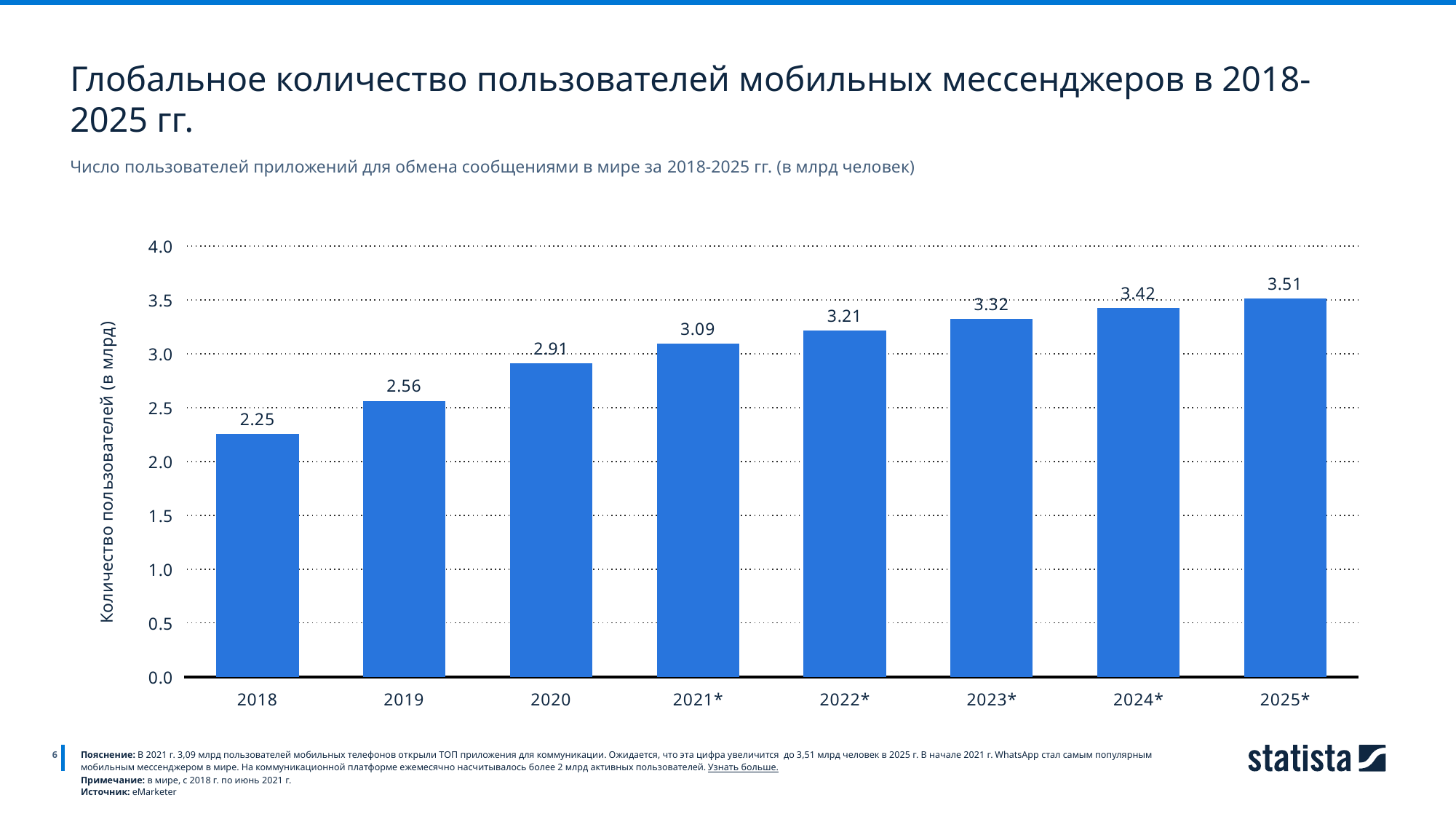
What is the value for 2025*? 3.51 What is the value for 2018? 2.25 What is the value for 2021*? 3.09 Do the values rise or fall from 2018 to 2025*? rise What kind of chart is this? bar chart Is the value for 2019 greater or less than 3.0? less Which year has the highest value? 2025* Which is larger, the value for 2022* or the value for 2020? 2022* How many years are shown on the x axis? 8 What is the difference between the values for 2020 and 2019? 0.35 Which year has the lowest value? 2018 What is the difference between the values for 2025* and 2018? 1.26